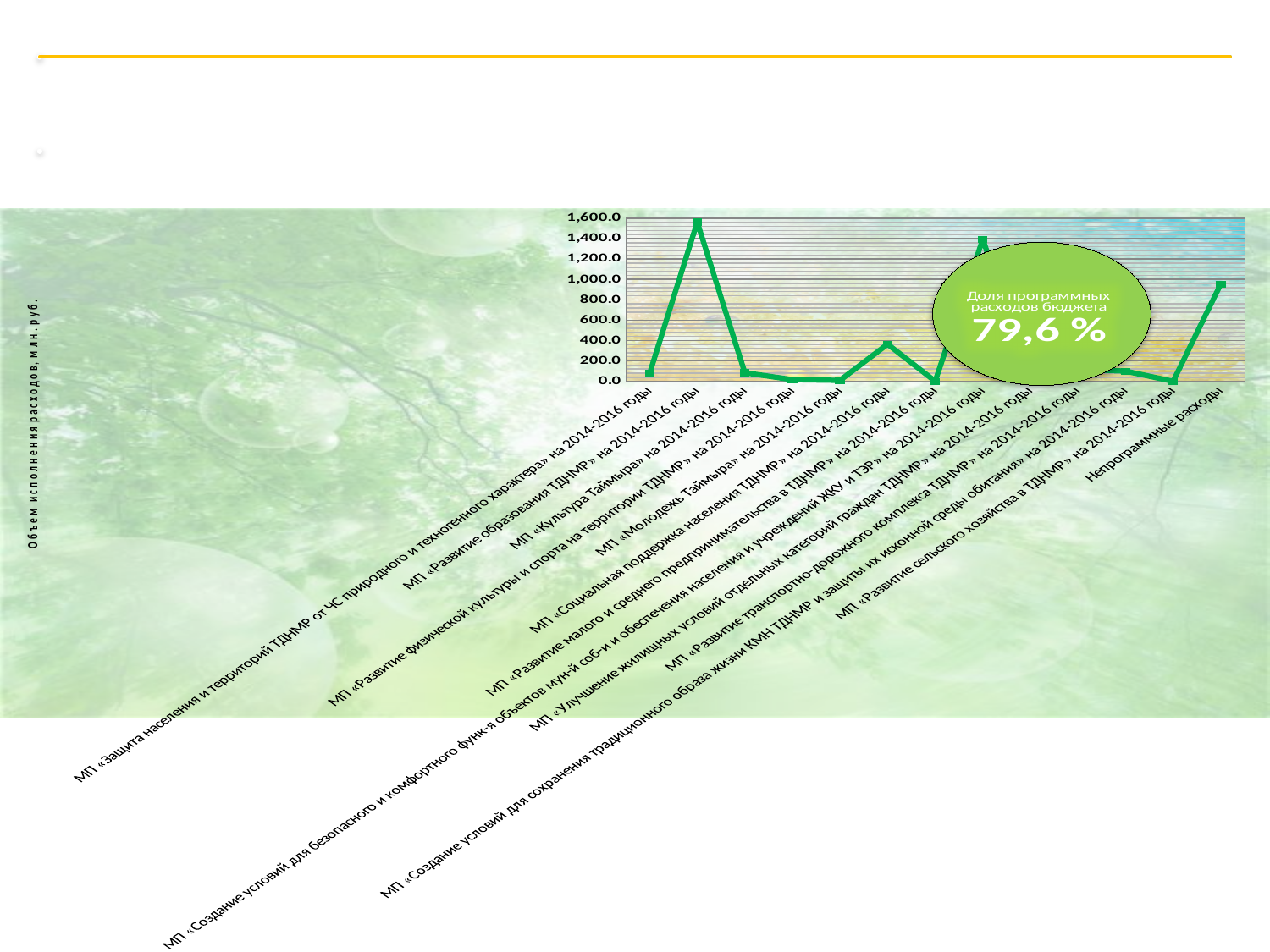
Is the value for МП «Развитие образования ТДНМР» на 2014-2016 годы greater or less than 1,400.0? greater Which category has the highest value on the chart? МП «Развитие образования ТДНМР» на 2014-2016 годы Is the value for МП «Социальная поддержка населения ТДНМР» на 2014-2016 годы greater or less than 600.0? less What kind of chart is shown on the slide? Line chart Is the value for МП «Улучшение жилищных условий отдельных категорий граждан ТДНМР» на 2014-2016 годы greater or less than 1,200.0? less Which is larger: the value for Непрограммные расходы or the value for МП «Социальная поддержка населения ТДНМР» на 2014-2016 годы? Непрограммные расходы Which is larger: the value for МП «Развитие образования ТДНМР» на 2014-2016 годы or the value for МП «Улучшение жилищных условий отдельных категорий граждан ТДНМР» на 2014-2016 годы? МП «Развитие образования ТДНМР» на 2014-2016 годы What share of budget expenditures is programme-based, according to the oval callout on the chart? 79,6 % What is the title of the vertical axis of the chart? Объем исполнения расходов, млн.руб. How many categories are plotted along the x axis of the chart? 13